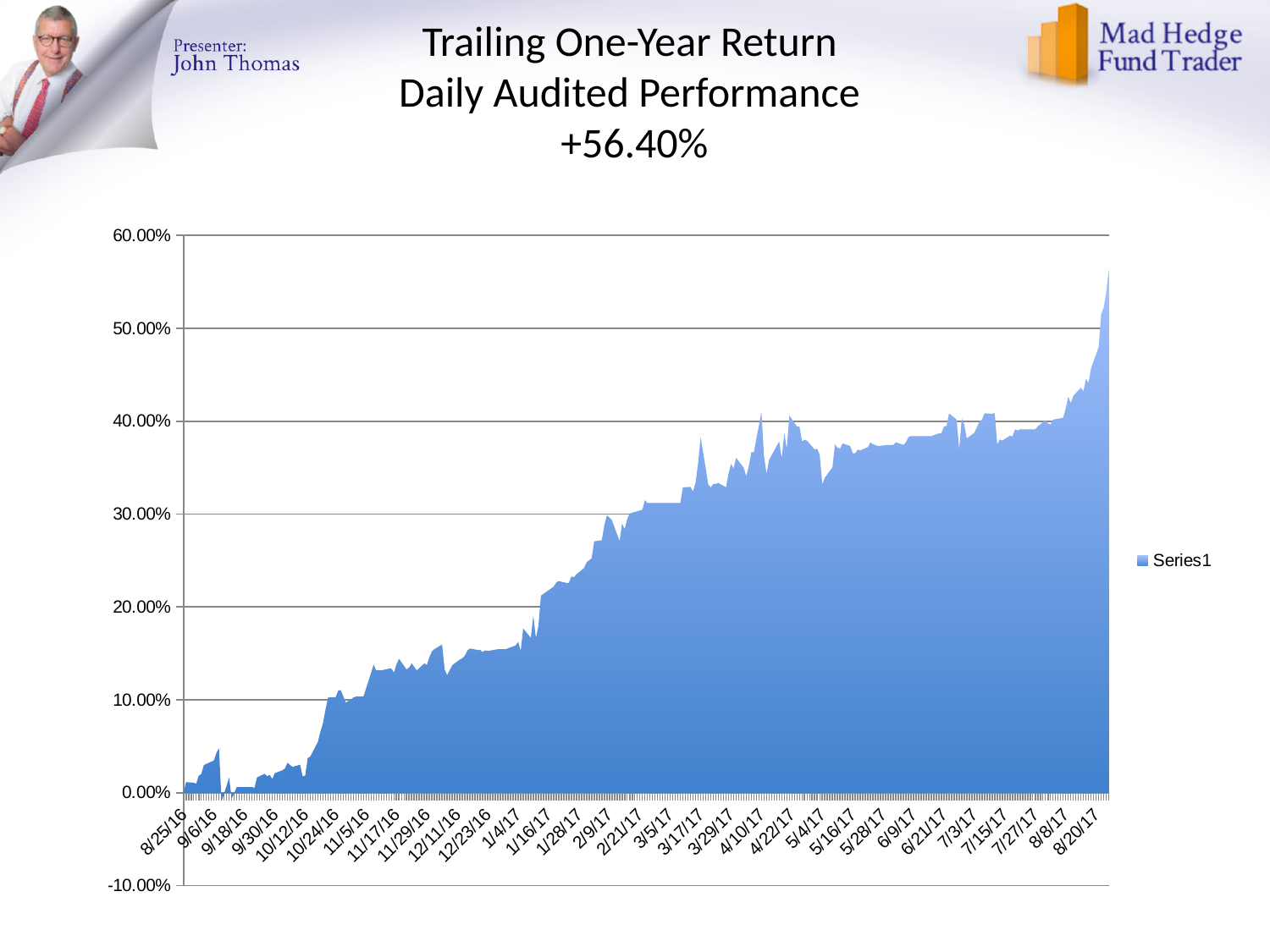
Is the value at 5/4/17 greater or less than 30.00%? greater Do the values generally rise or fall from 8/25/16 to 8/20/17? rise What kind of chart is shown on the slide? area chart Is the value at 8/25/16 greater or less than 10.00%? less Near which x-axis date does the chart reach its highest value? 8/20/17 How many series does the legend list? 1 What return figure is stated in the slide title? +56.40% Is the value at 11/5/16 greater or less than 20.00%? less What is the name of the series shown in the legend? Series1